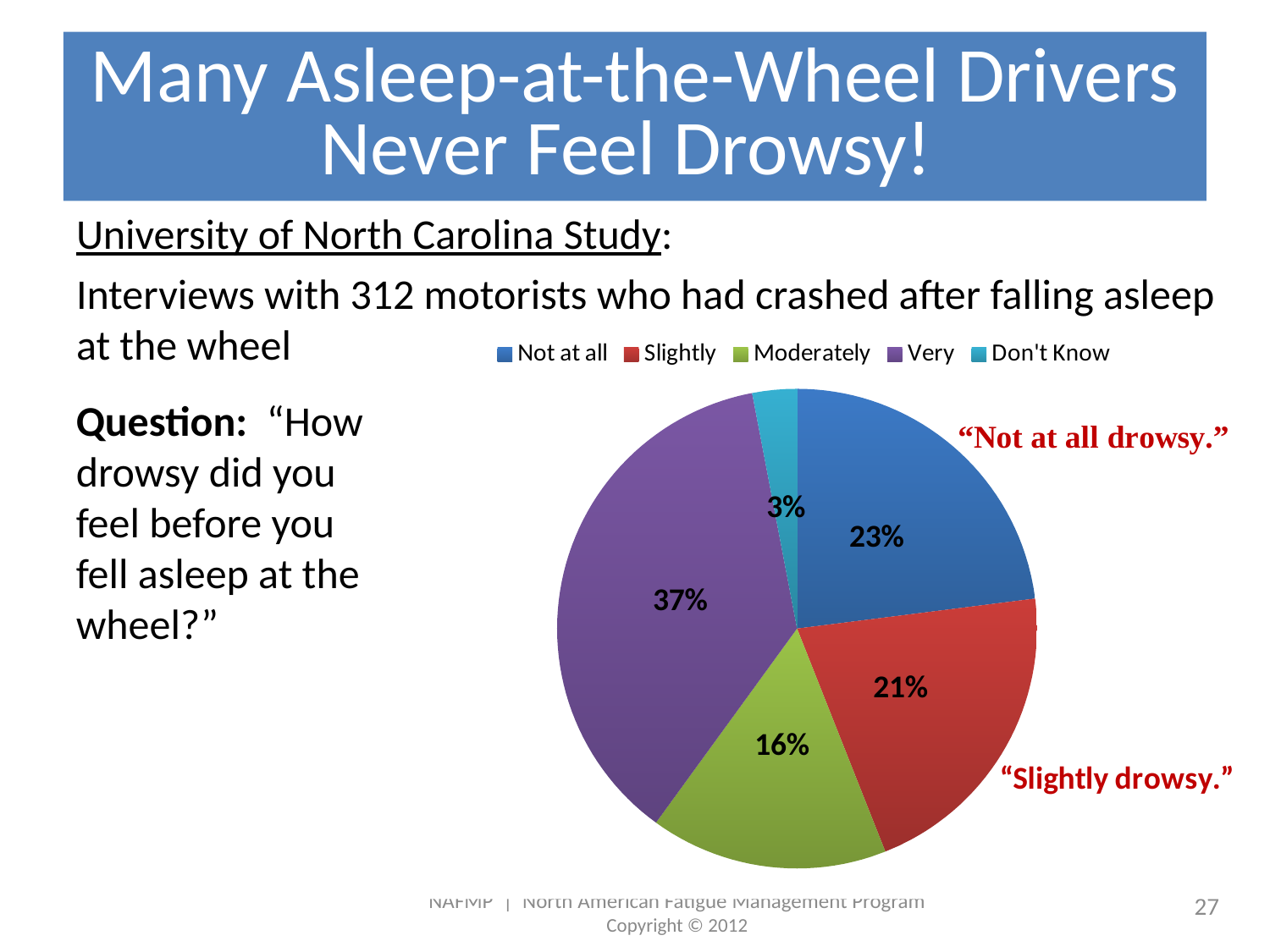
What percentage is shown for the "Very" slice? 37% What percentage is shown for the "Moderately" slice? 16% Which category has the largest share of the pie? Very What percentage of the pie is labelled for the "Not at all" slice? 23% What percentage is shown for the "Don't Know" slice? 3% What colour is the "Very" slice in the pie chart? purple Which category has the smallest share of the pie? Don't Know How many categories does the legend list? 5 What kind of chart is shown on the slide? pie chart What percentage is shown for the "Slightly" slice? 21% Which slice is larger, "Slightly" or "Moderately"? Slightly What is the difference in percentage points between the "Very" slice and the "Not at all" slice? 14